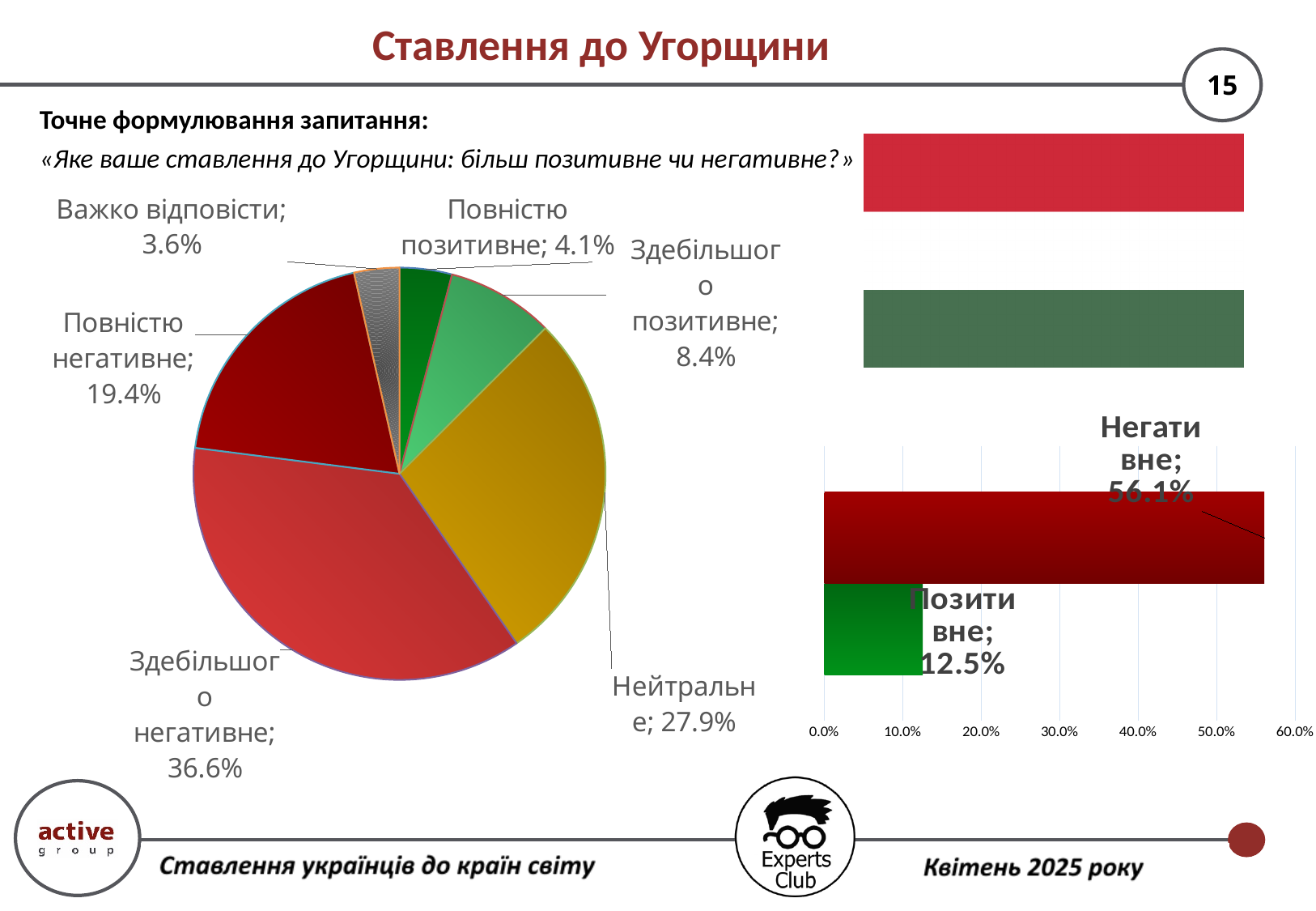
In the pie chart, what share of respondents answered "Повністю негативне"? 19.4% In the bar chart on the right, what is the difference between the values for "Негативне" and "Позитивне"? 43.6% In the pie chart, how many slices are there? 6 What type of chart is shown on the right side of the slide? Bar chart In the pie chart, what is the difference between the shares for "Здебільшого позитивне" and "Повністю позитивне"? 4.3% In the pie chart, which category has the smallest share? Важко відповісти In the bar chart on the right, what is the value for "Позитивне"? 12.5% In the pie chart, which category has the largest share? Здебільшого негативне In the bar chart on the right, what is the value for "Негативне"? 56.1% In the pie chart, what share of respondents answered "Важко відповісти"? 3.6% In the pie chart, what share of respondents answered "Нейтральне"? 27.9% In the pie chart, what share of respondents answered "Здебільшого негативне"? 36.6%